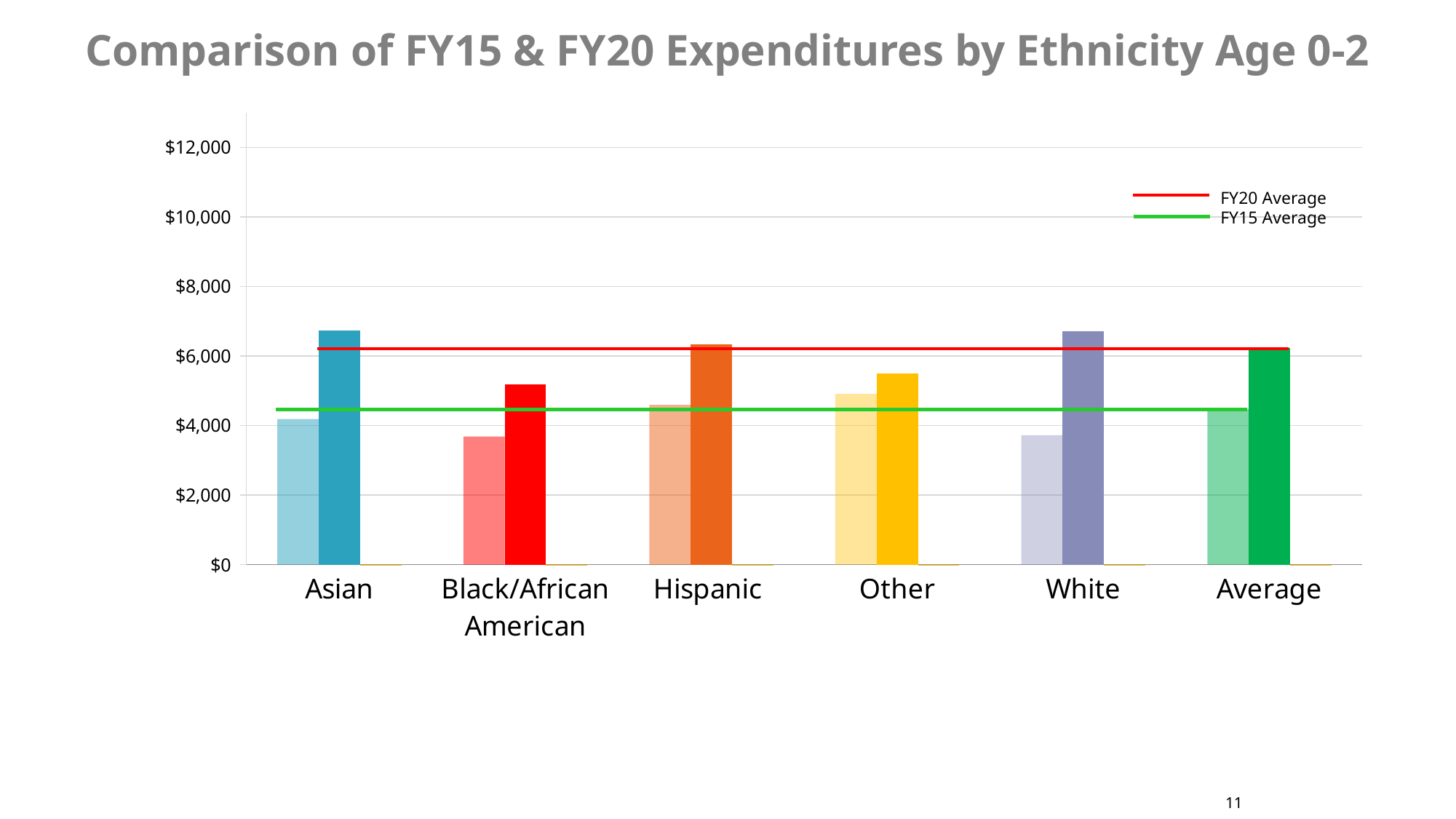
Is the value of the darker (right) bar for Hispanic greater or less than $6,000? greater Is the value of the darker (right) bar for Other greater or less than $6,000? less What kind of chart is shown on the slide? bar chart How many categories are shown along the x axis of the chart? 6 Which two entries appear in the chart's legend? FY20 Average and FY15 Average How many series does the chart's legend list? 2 Is the value of the darker (right) bar for Asian greater or less than $6,000? greater What is the title of the chart? Comparison of FY15 & FY20 Expenditures by Ethnicity Age 0-2 Which is larger: the darker (right) bar for Asian or the darker (right) bar for Black/African American? Asian Which horizontal line is higher on the chart, the FY20 Average line or the FY15 Average line? FY20 Average